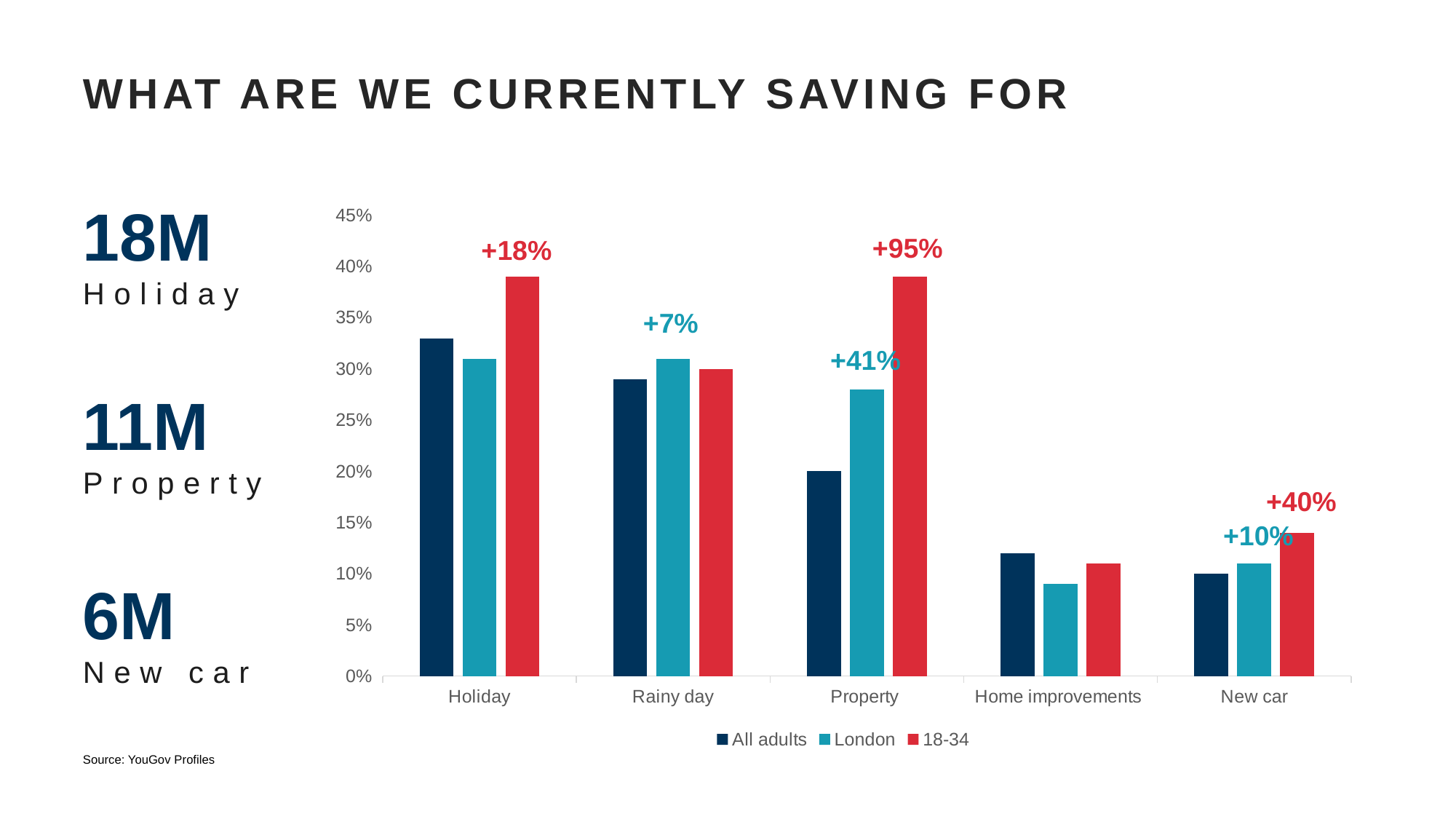
What kind of chart is shown on the slide? bar chart Is the value for London in the Property category greater or less than 25%? greater How many series does the chart legend list? 3 In the Property category, which is larger: the London value or the All adults value? London What percentage annotation is printed above the 18-34 bar for Property? +95% Is the value for All adults in the Holiday category greater or less than 30%? greater Which category has the lowest value for All adults? New car Which series are listed in the chart legend? All adults, London, 18-34 How many categories are shown on the x axis of the chart? 5 Which category has the highest value for All adults? Holiday Is the value for 18-34 in the Holiday category greater or less than 35%? greater